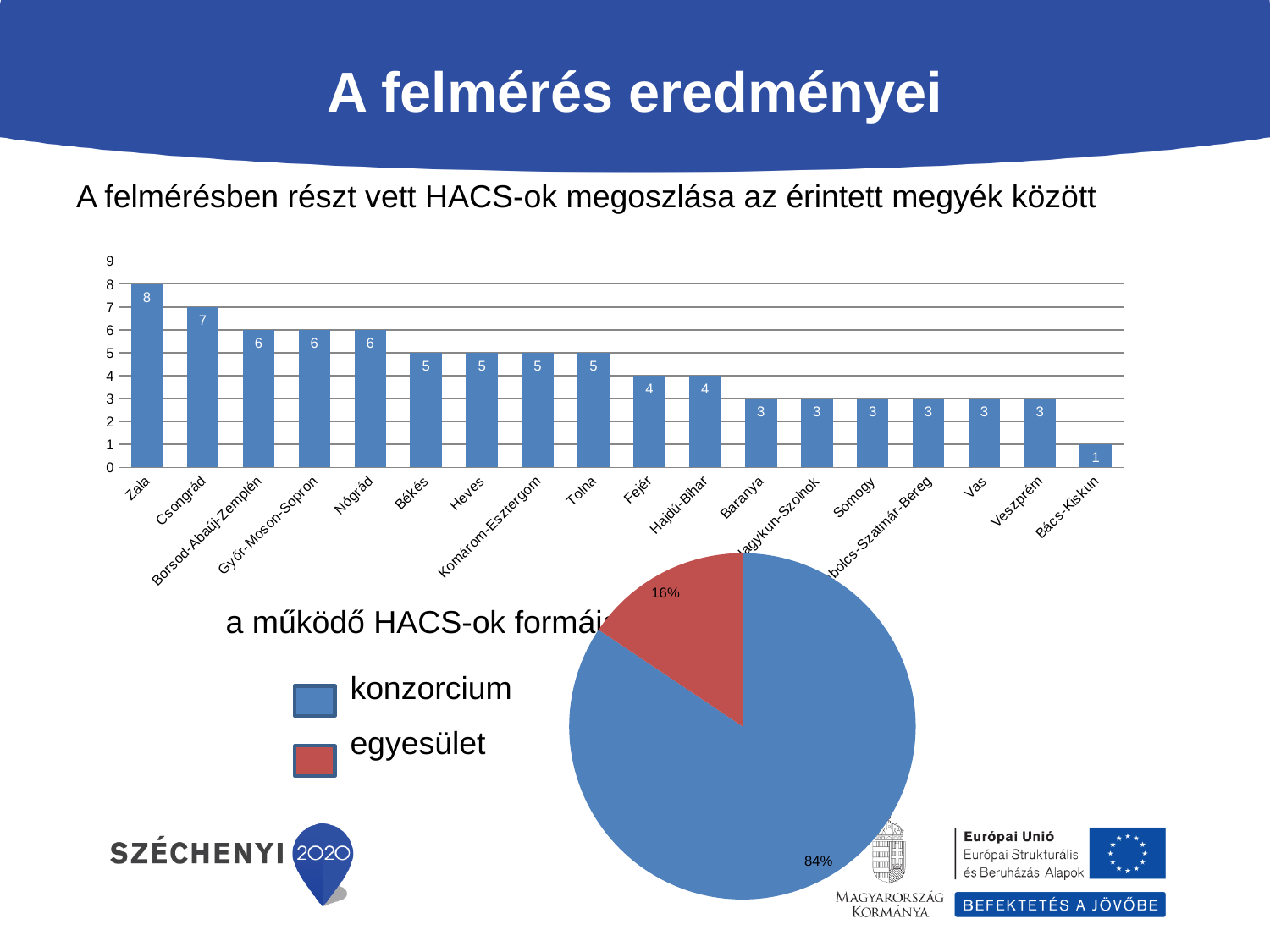
In the bar chart at the top of the slide, what is the value for Csongrád? 7 In the pie chart at the bottom of the slide, what share does konzorcium have? 84% In the pie chart at the bottom of the slide, what share does egyesület have? 16% What kind of chart is the top chart on the slide? bar chart How many counties are shown in the bar chart at the top of the slide? 18 In the bar chart at the top of the slide, what is the difference between the values for Zala and Tolna? 3 In the bar chart at the top of the slide, which county has the lowest value? Bács-Kiskun In the bar chart at the top of the slide, which is larger, the value for Nógrád or the value for Fejér? Nógrád In the bar chart at the top of the slide, which county has the highest value? Zala How many entries does the legend of the pie chart at the bottom of the slide list? 2 In the bar chart at the top of the slide, what is the value for Zala? 8 In the bar chart at the top of the slide, what is the value for Bács-Kiskun? 1